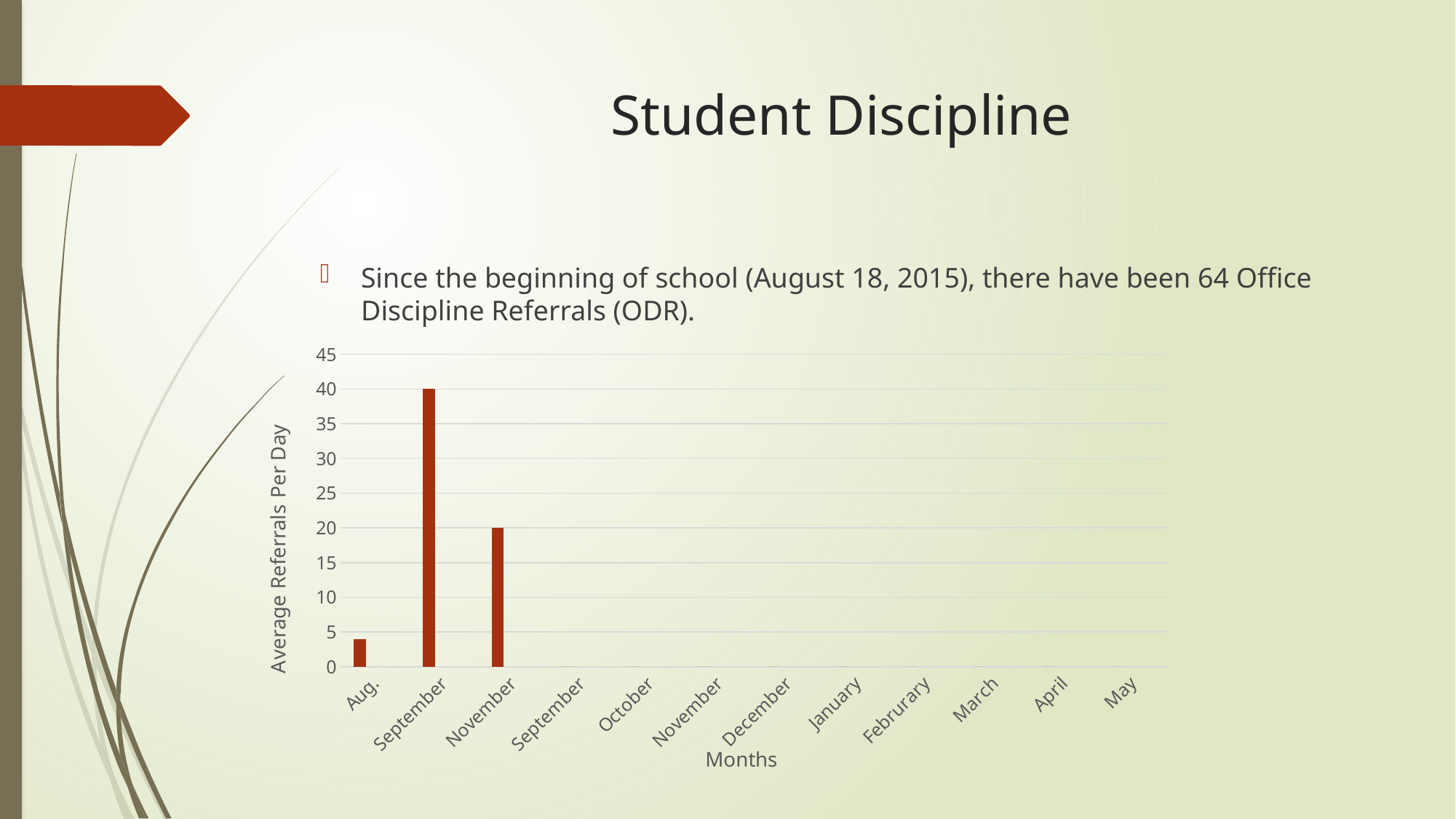
How many month categories are shown on the x axis? 12 What is the label of the x axis? Months What is the difference between the tallest bar (40) and the bar for the first November category (20)? 20 Is the value for Aug. greater or less than 10? less What is the value of the tallest bar in the chart? 40 What kind of chart is shown on the slide? bar chart How many categories have a visible bar above zero? 3 What is the value of the bar for the first November category (the third bar from the left)? 20 Which is larger, the bar for Aug. or the bar for the first November category? November What is the label of the y axis? Average Referrals Per Day Which category has the tallest bar? September (the second category, right after Aug.) What is the highest value shown on the y axis? 45